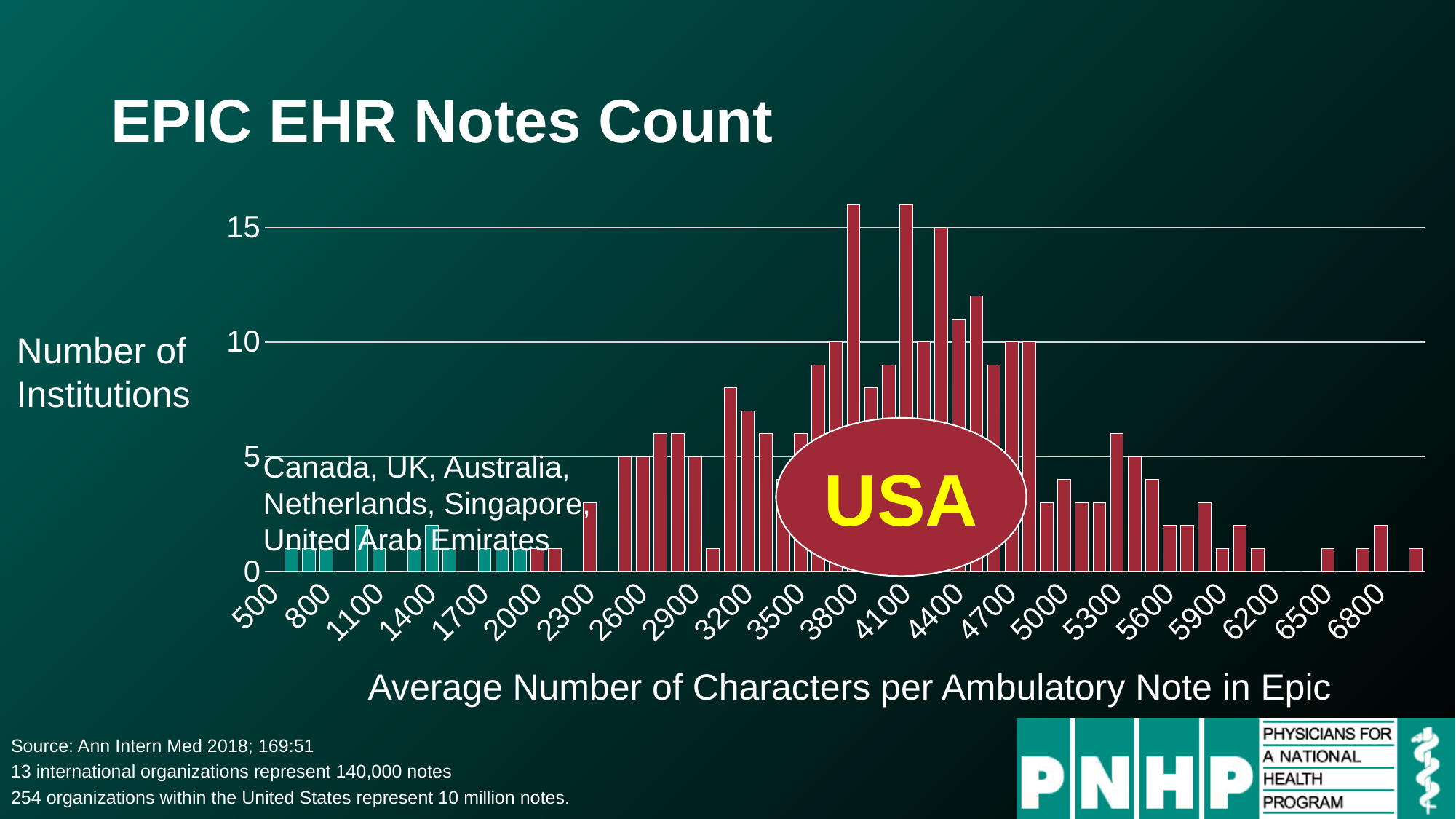
Is the value for 2300 greater or less than 5? less Is the value for 500 greater or less than 5? less Do the values generally rise or fall along the x axis from 500 to 3800? rise Is the value for 4400 greater or less than 5? greater What kind of chart is shown on the slide? bar chart What is the title of the x axis of the chart? Average Number of Characters per Ambulatory Note in Epic What label is written inside the red oval on the chart? USA Do the values generally rise or fall along the x axis from 4700 to 6800? fall Which is larger, the value for 4100 or the value for 6800? 4100